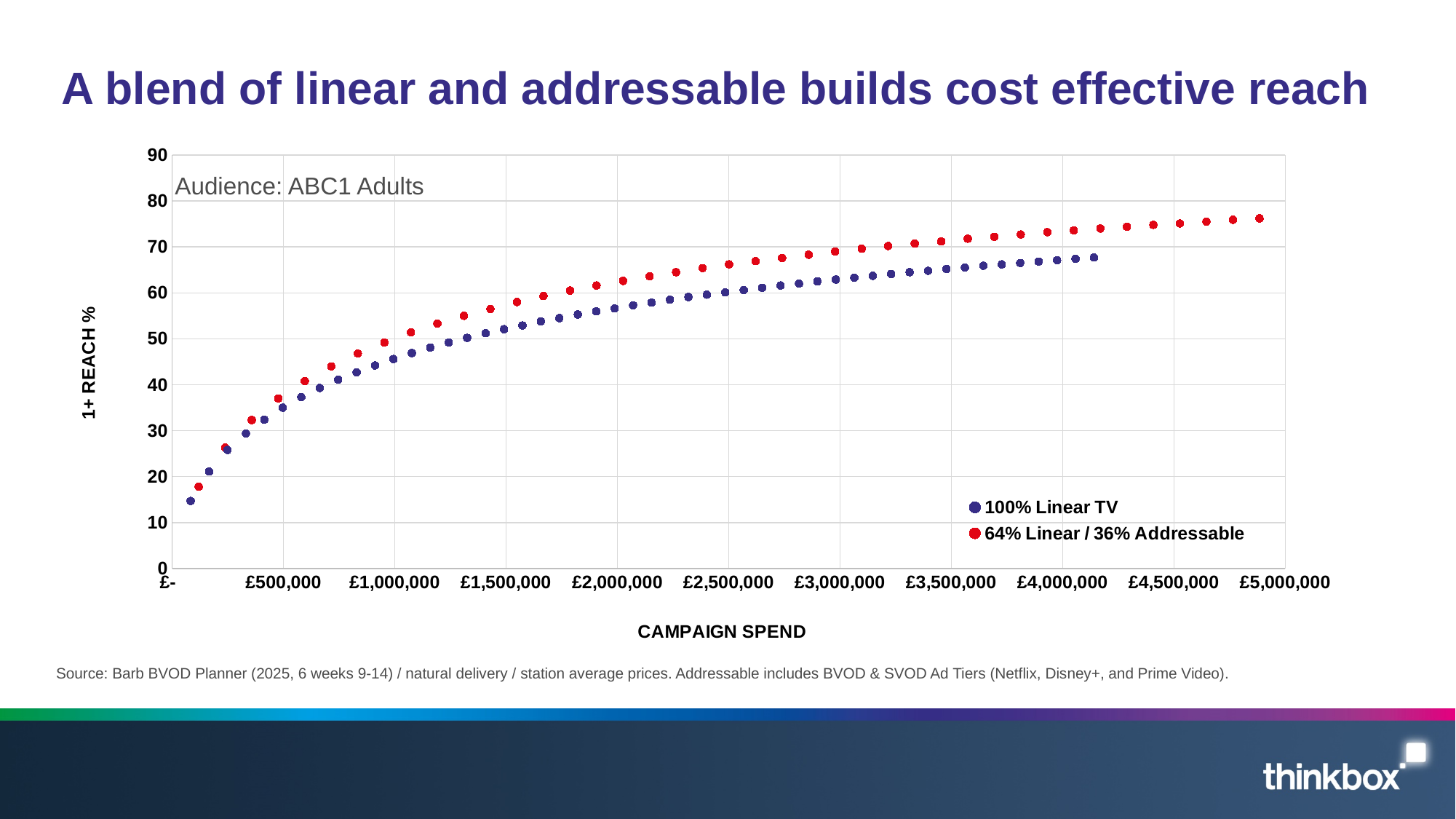
Is the 1+ reach % for 64% Linear / 36% Addressable at £5,000,000 spend greater or less than 70? greater Which series reaches the highest 1+ reach % on the chart? 64% Linear / 36% Addressable Is the 1+ reach % for 64% Linear / 36% Addressable at £2,000,000 spend greater or less than 60? greater At a campaign spend of £3,000,000, which series shows the higher 1+ reach %? 64% Linear / 36% Addressable What is the label of the vertical axis? 1+ REACH % Do the reach values rise or fall as campaign spend increases? Rise Is the 1+ reach % for 100% Linear TV at £4,000,000 spend greater or less than 70? less What are the two series named in the legend? 100% Linear TV; 64% Linear / 36% Addressable What kind of chart is shown on the slide? Scatter chart How many series does the legend list? 2 Which series extends to the higher campaign spend on the x axis? 64% Linear / 36% Addressable